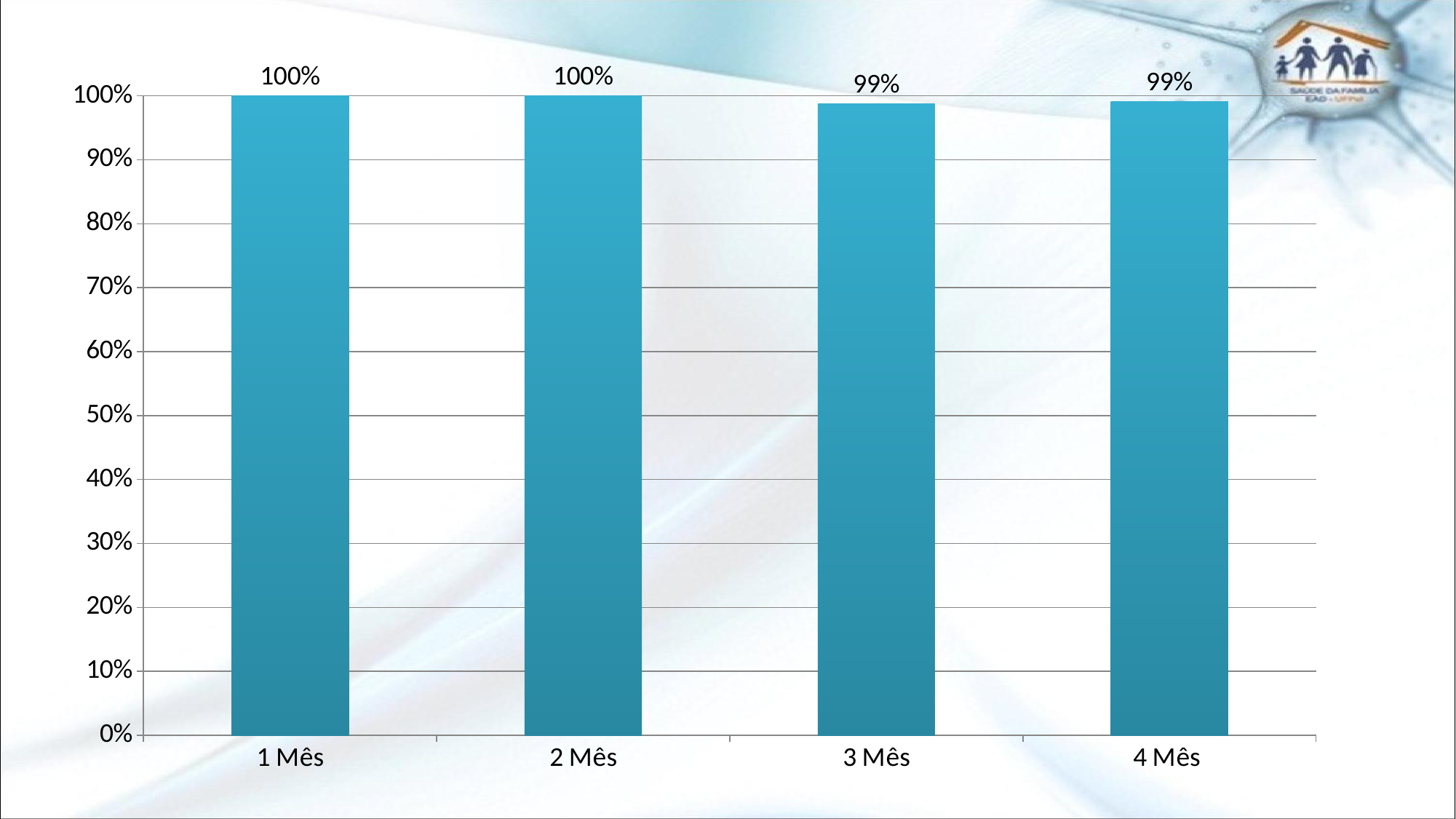
What is the value for 4 Mês? 99% What is the difference between the values for 1 Mês and 3 Mês? 1% Is the value for 3 Mês greater or less than 90%? greater Do the values rise or fall from 1 Mês to 4 Mês? fall What is the value for 2 Mês? 100% Which has the larger value, 1 Mês or 4 Mês? 1 Mês What is the highest value shown on the y axis? 100% What is the difference between the values for 2 Mês and 4 Mês? 1% What kind of chart is shown on the slide? bar chart What is the value for 3 Mês? 99% How many categories are shown on the x axis? 4 What is the value for 1 Mês? 100%